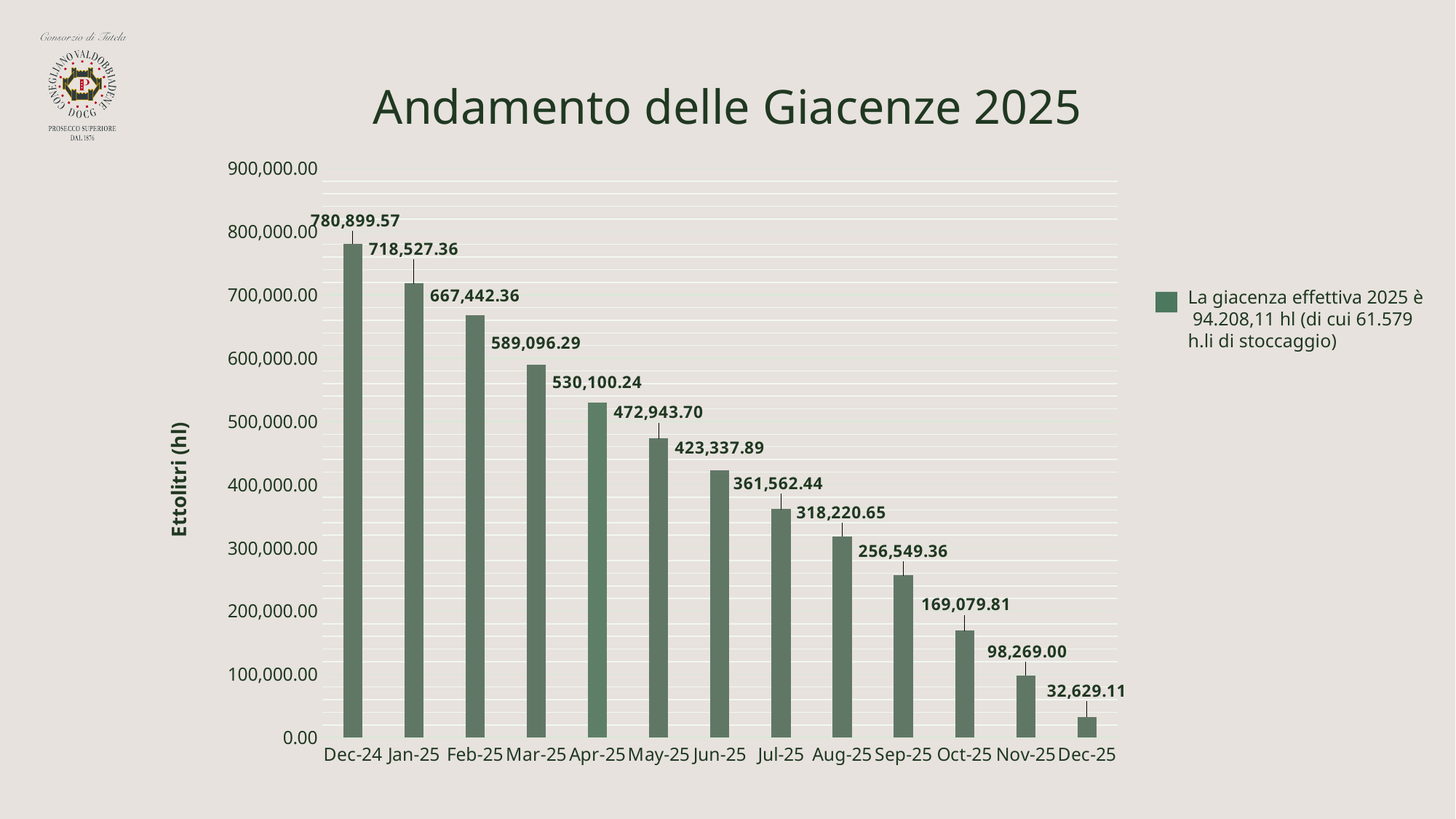
What is the value for Dec-24? 780,899.57 Which is larger, the value for Apr-25 or the value for Jul-25? Apr-25 Is the value for Sep-25 greater or less than 300,000.00? less Which month has the lowest value? Dec-25 What is the value for Nov-25? 98,269.00 What kind of chart is shown on the slide? bar chart Do the values rise or fall from Dec-24 to Dec-25? fall What is the value for Jun-25? 423,337.89 How many months are shown on the x axis? 13 Which month has the highest value? Dec-24 What is the difference between the values for Jan-25 and Feb-25? 51,085.00 What is the title of the chart? Andamento delle Giacenze 2025